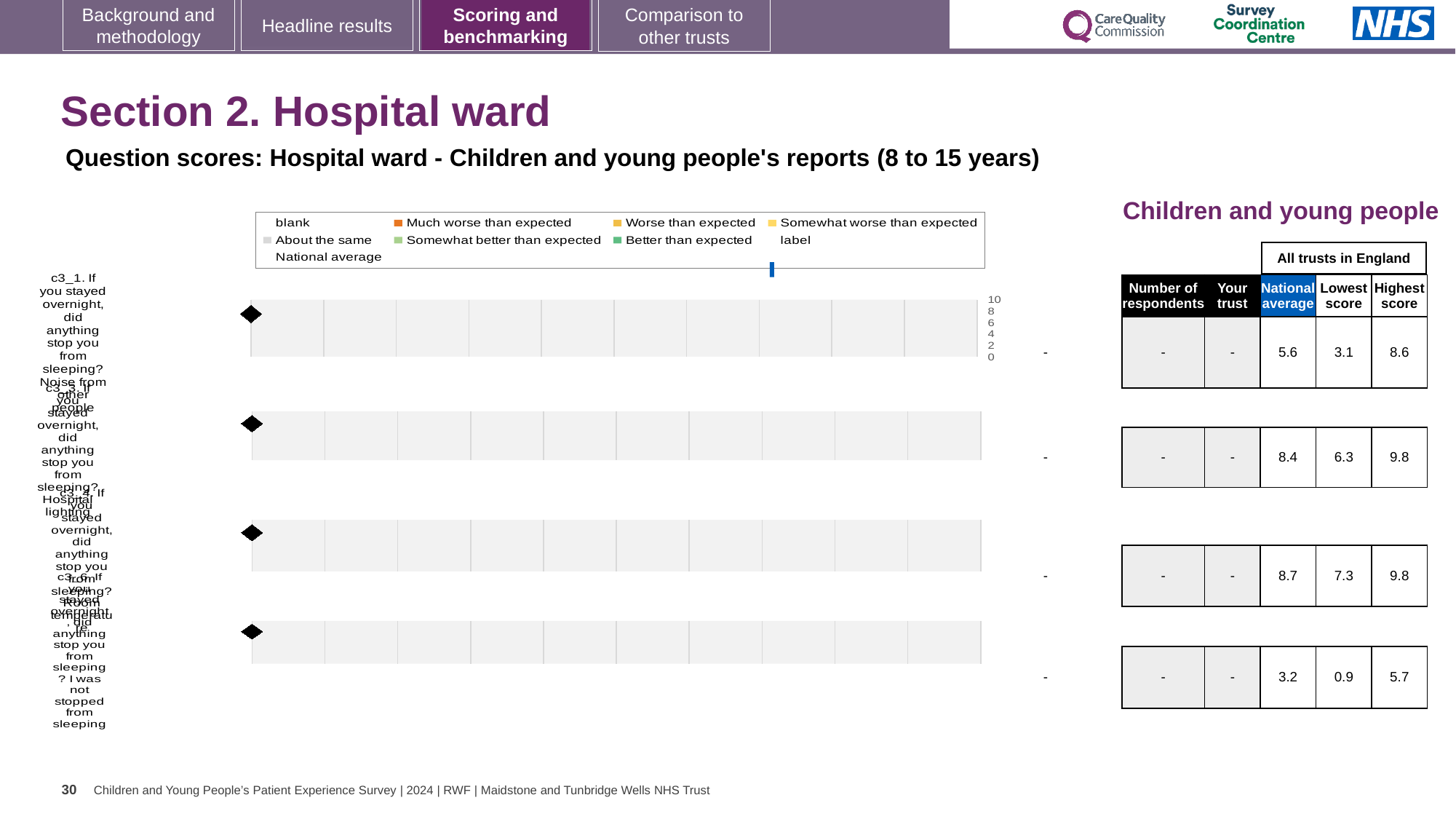
What is the highest value shown on the chart's axis? 10 Which row in the table has the highest national average? c3_4 (room temperature), 8.7 In the table, what is the difference between the highest score and the lowest score for the first row (c3_1)? 5.5 What kind of chart is shown on the slide? bar chart In the table, what is the lowest score for the third row (c3_4, room temperature)? 7.3 In the table, what is the national average for the fourth row (c3_6, I was not stopped from sleeping)? 3.2 In the table, what is the national average for the first row (c3_1, noise from other people)? 5.6 What is the heading above the table to the right of the chart? Children and young people Which row in the table has the lowest national average? c3_6 (I was not stopped from sleeping), 3.2 In the table, what is the highest score for the second row (c3_3, hospital lighting)? 9.8 How many question rows (bars) does the chart show? 4 How many entries does the chart legend list? 9